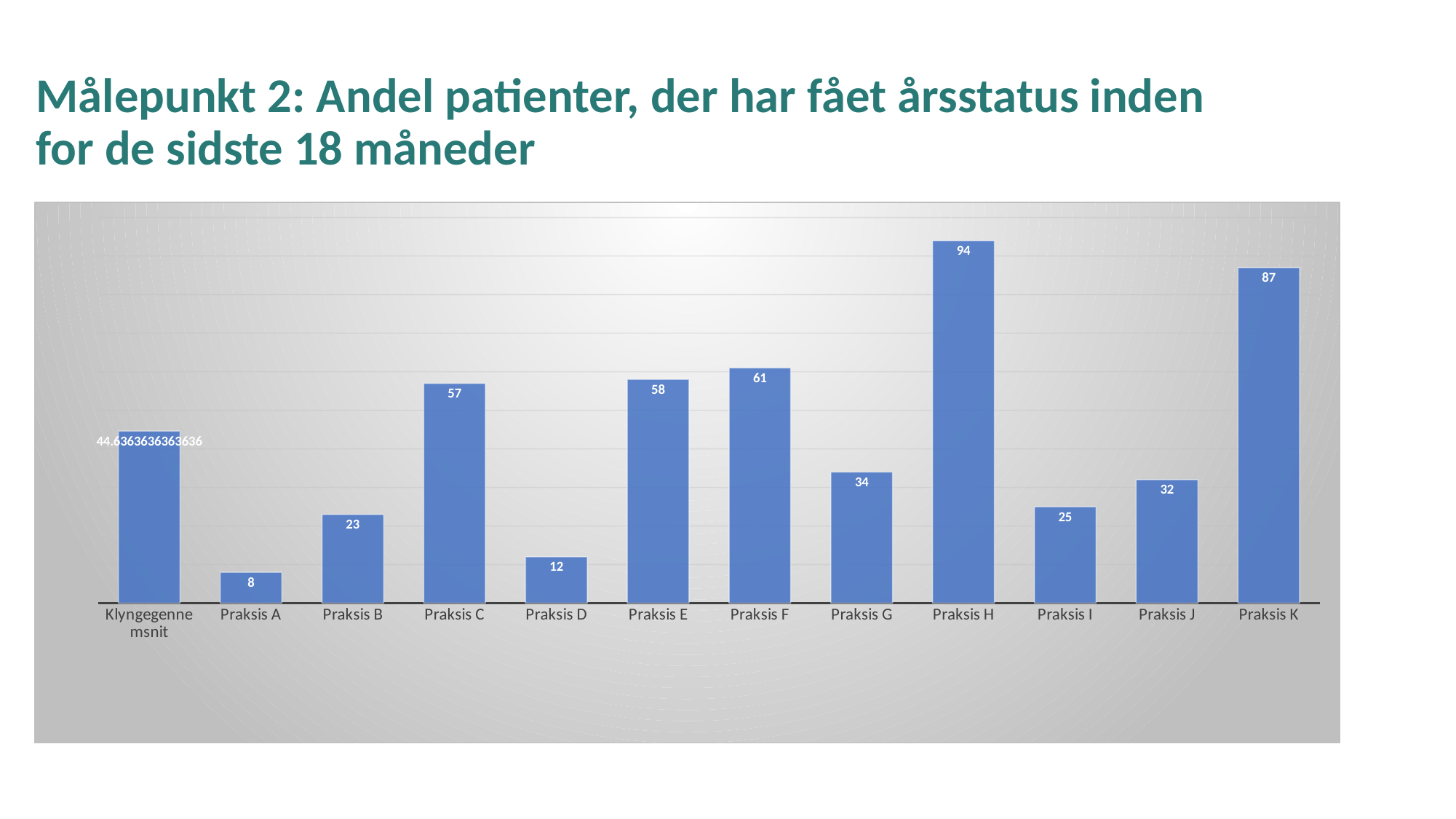
Which is larger, the value for Praksis E or the value for Praksis G? Praksis E What is the value for Praksis H? 94 What is the value shown for Klyngegennemsnit? 44.6363636363636 How many categories are shown on the x axis? 12 What kind of chart is shown on the slide? Bar chart What is the value for Praksis D? 12 Which is larger, the value for Praksis I or the value for Praksis J? Praksis J Which category has the highest value? Praksis H What is the difference between the values for Praksis F and Praksis B? 38 What is the difference between the values for Praksis H and Praksis K? 7 Which category has the lowest value? Praksis A What is the title of the slide? Målepunkt 2: Andel patienter, der har fået årsstatus inden for de sidste 18 måneder